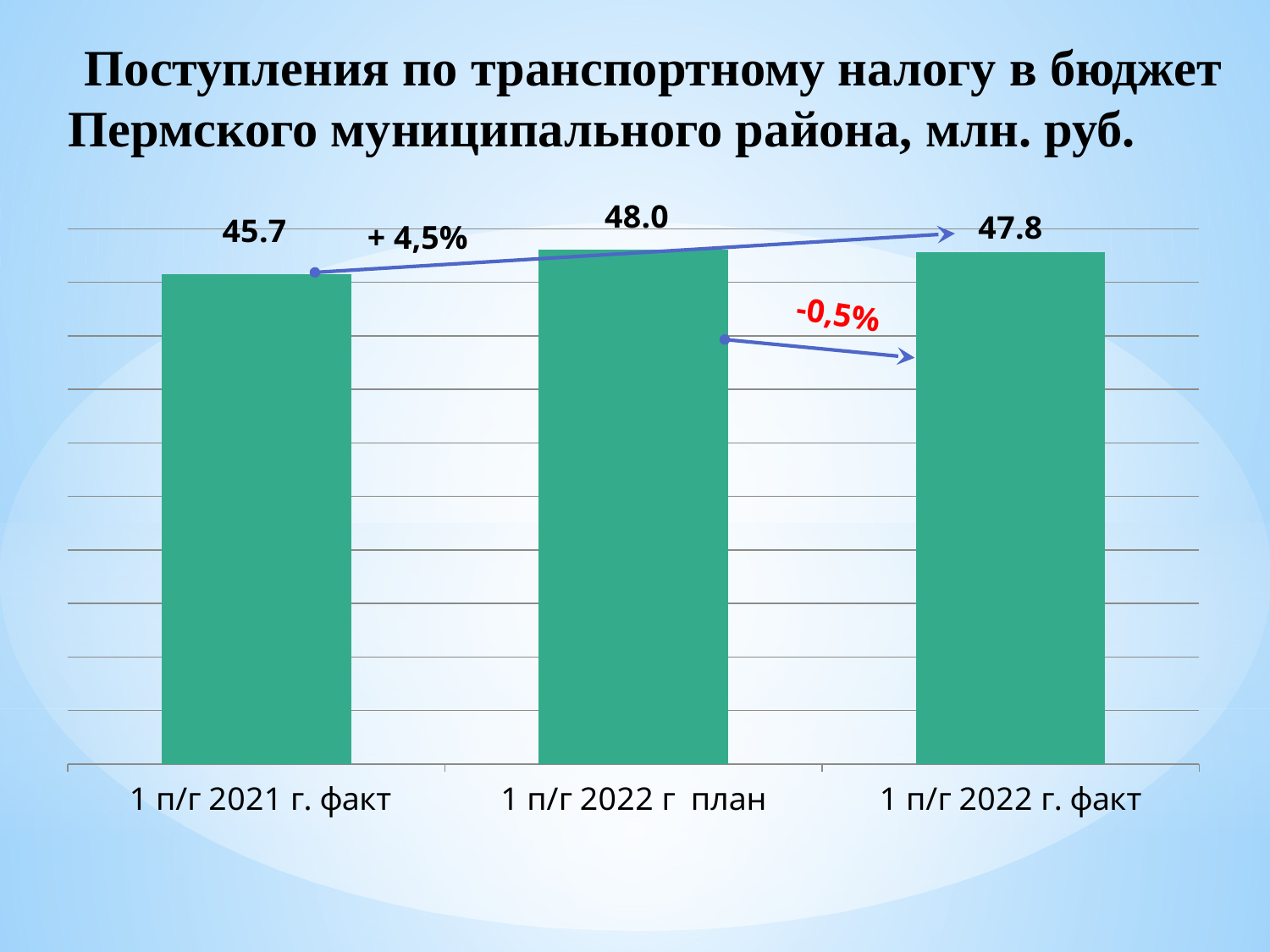
What is the difference between the values for 1 п/г 2022 г план and 1 п/г 2022 г. факт? 0.2 Which category has the highest value? 1 п/г 2022 г план Which is larger, the value for 1 п/г 2021 г. факт or the value for 1 п/г 2022 г. факт? 1 п/г 2022 г. факт Which category has the lowest value? 1 п/г 2021 г. факт What is the value for 1 п/г 2021 г. факт? 45.7 How many bars are shown in the chart? 3 What percentage change is annotated between 1 п/г 2022 г план and 1 п/г 2022 г. факт? -0,5% What is the value for 1 п/г 2022 г план? 48.0 What kind of chart is shown on the slide? bar chart What is the difference between the values for 1 п/г 2022 г план and 1 п/г 2021 г. факт? 2.3 What percentage change is annotated between 1 п/г 2021 г. факт and 1 п/г 2022 г план? + 4,5% What is the value for 1 п/г 2022 г. факт? 47.8